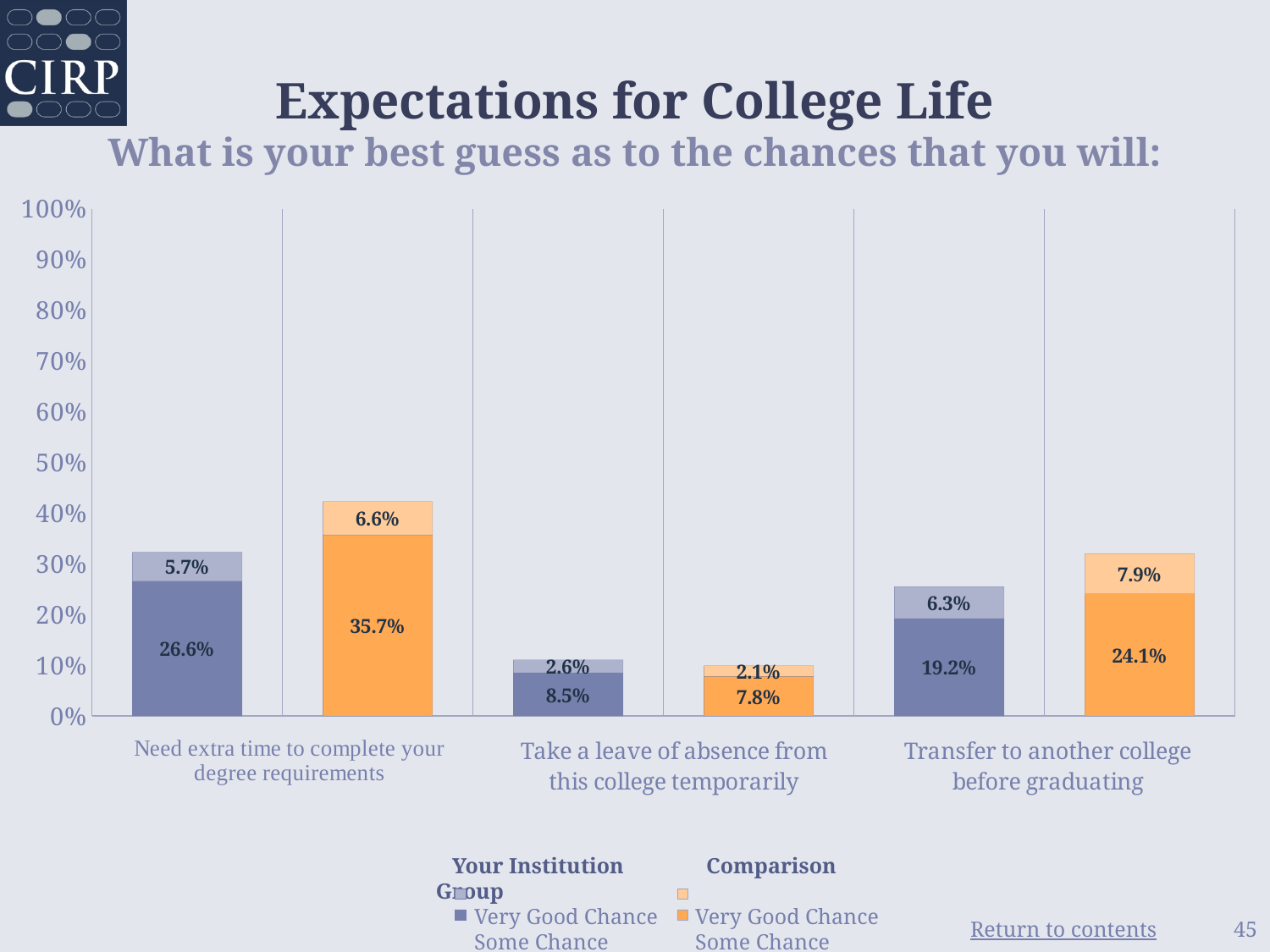
What type of chart is shown on the slide? Stacked bar chart What is the 'Very Good Chance' value for Your Institution for 'Need extra time to complete your degree requirements'? 5.7% What is the 'Some Chance' value for Your Institution for 'Take a leave of absence from this college temporarily'? 8.5% For 'Take a leave of absence from this college temporarily', which is larger: the 'Very Good Chance' value for Your Institution or for the Comparison Group? Your Institution How many categories are shown on the x axis of the chart? 3 Which category has the highest 'Very Good Chance' value for the Comparison Group? Transfer to another college before graduating What is the total of the stacked bar for Your Institution for 'Transfer to another college before graduating'? 25.5% What is the 'Very Good Chance' value for the Comparison Group for 'Transfer to another college before graduating'? 7.9% Which category has the lowest 'Very Good Chance' value for Your Institution? Take a leave of absence from this college temporarily What is the total of the stacked bar for the Comparison Group for 'Need extra time to complete your degree requirements'? 42.3% What is the difference between the Comparison Group and Your Institution 'Very Good Chance' values for 'Need extra time to complete your degree requirements'? 0.9% What is the 'Some Chance' value for the Comparison Group for 'Need extra time to complete your degree requirements'? 35.7%